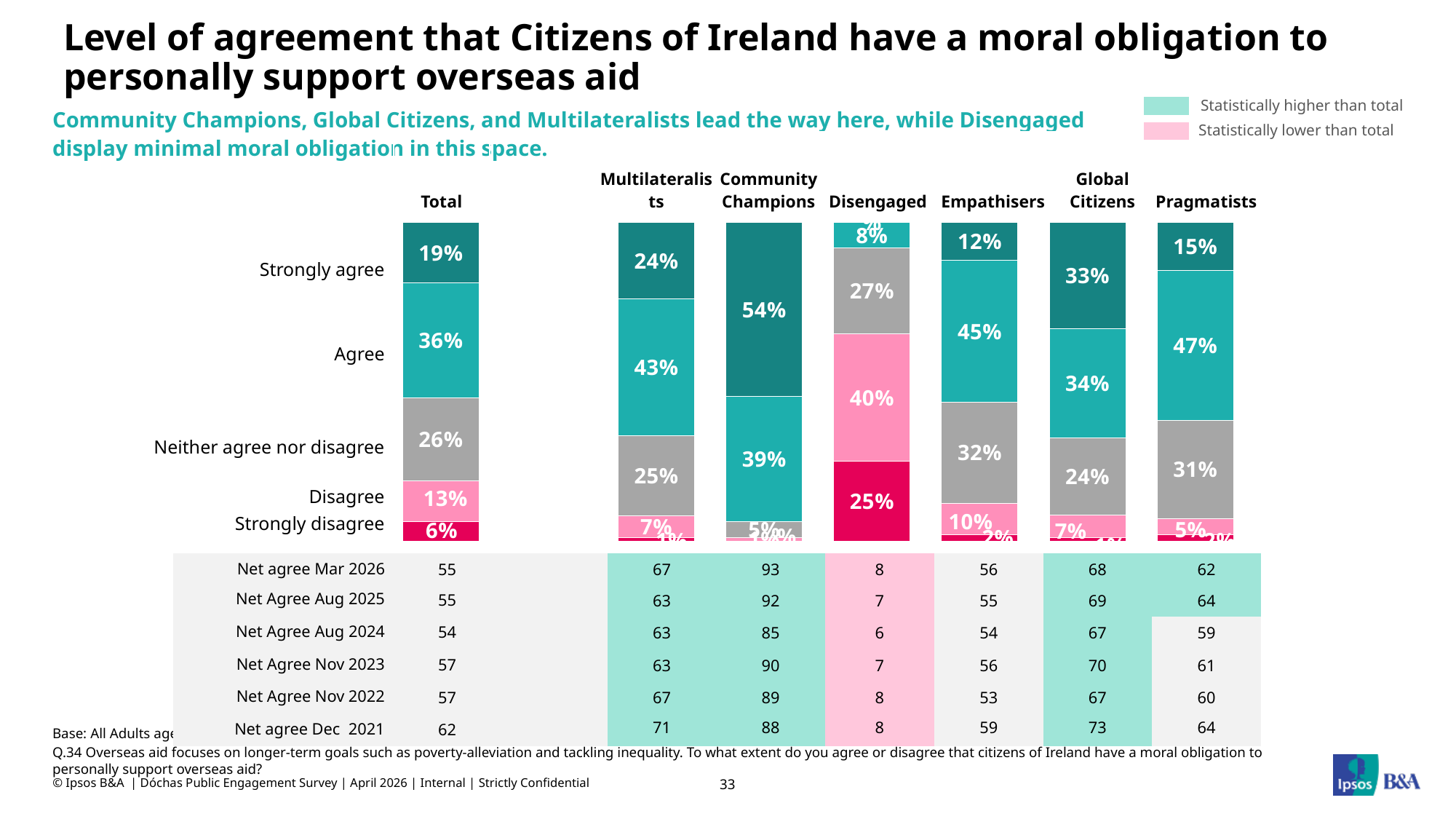
How many response categories are stacked in each bar? 5 Which group has the highest share of 'Disagree'? Disengaged Which group has the highest share of 'Strongly agree'? Community Champions What type of chart is shown on the slide? Stacked bar chart What does the light green shading in the legend indicate? Statistically higher than total What percentage of Pragmatists agree? 47% How many groups (bars) are shown in the chart? 7 Which group has a larger 'Agree' share, Pragmatists or Multilateralists? Pragmatists How many percentage points higher is 'Strongly agree' for Global Citizens than for Total? 14 percentage points What percentage of the Total group strongly agree? 19% What percentage of Community Champions strongly agree? 54% What percentage of the Disengaged group strongly disagree? 25%